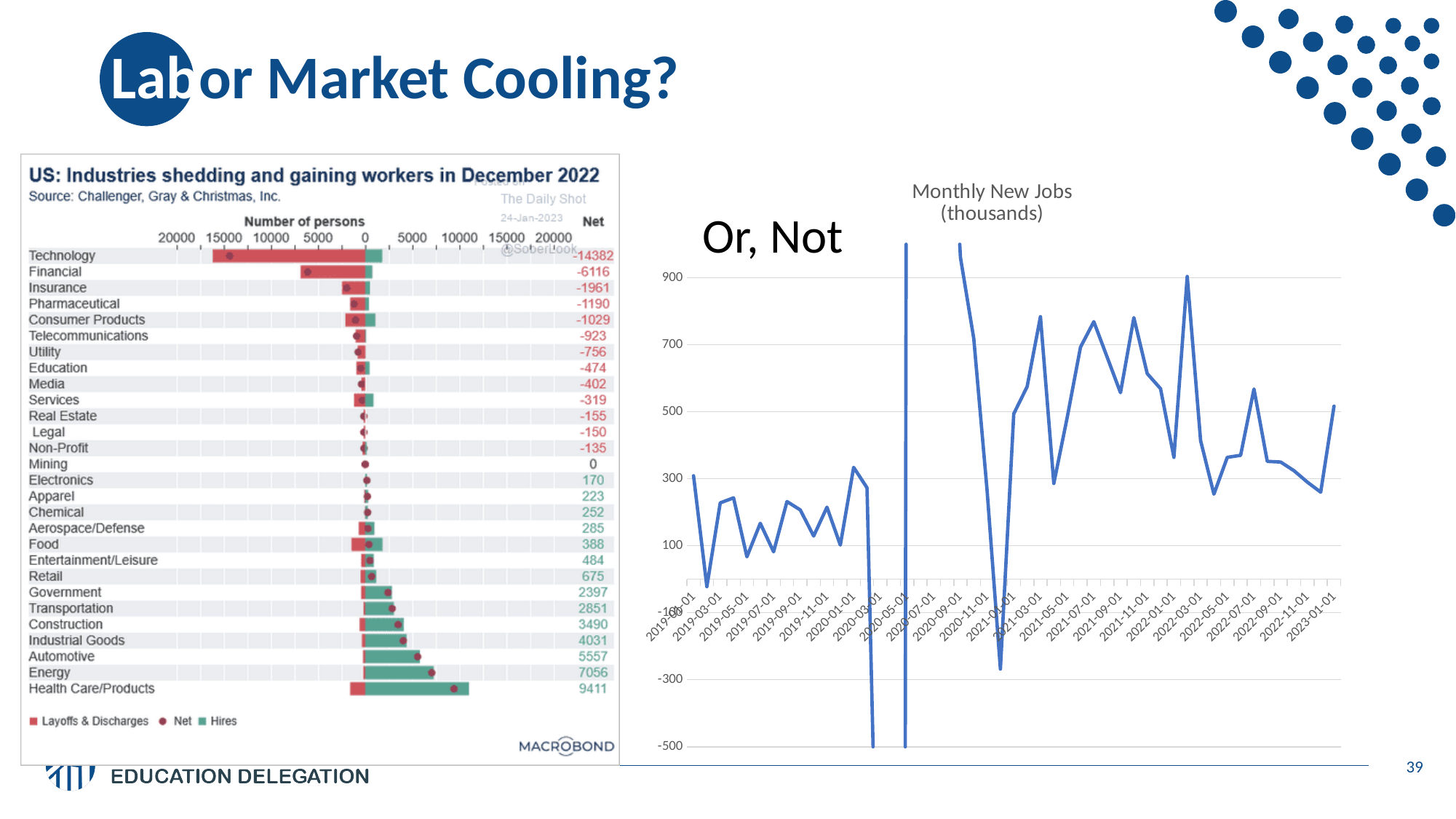
On the left chart, what is the Net value for Technology? -14382 On the left chart, what is the Net value for Health Care/Products? 9411 On the left chart, how many industries are listed? 28 On the left chart, what is the difference between the Net values for Energy and Automotive? 1499 On the left chart, which has the larger Net value, Construction or Government? Construction On the left chart, which industry has the lowest Net value? Technology On the left chart, which industry has the highest Net value? Health Care/Products What kind of chart is the 'Monthly New Jobs (thousands)' chart on the right? line chart On the right chart, is the value for 2021-01-01 greater or less than 100? greater On the right chart, do the values generally rise or fall from 2022-03-01 to 2022-11-01? fall On the right chart, is the value for 2022-03-01 greater or less than 700? less On the left chart, how many entries does the legend list? 3